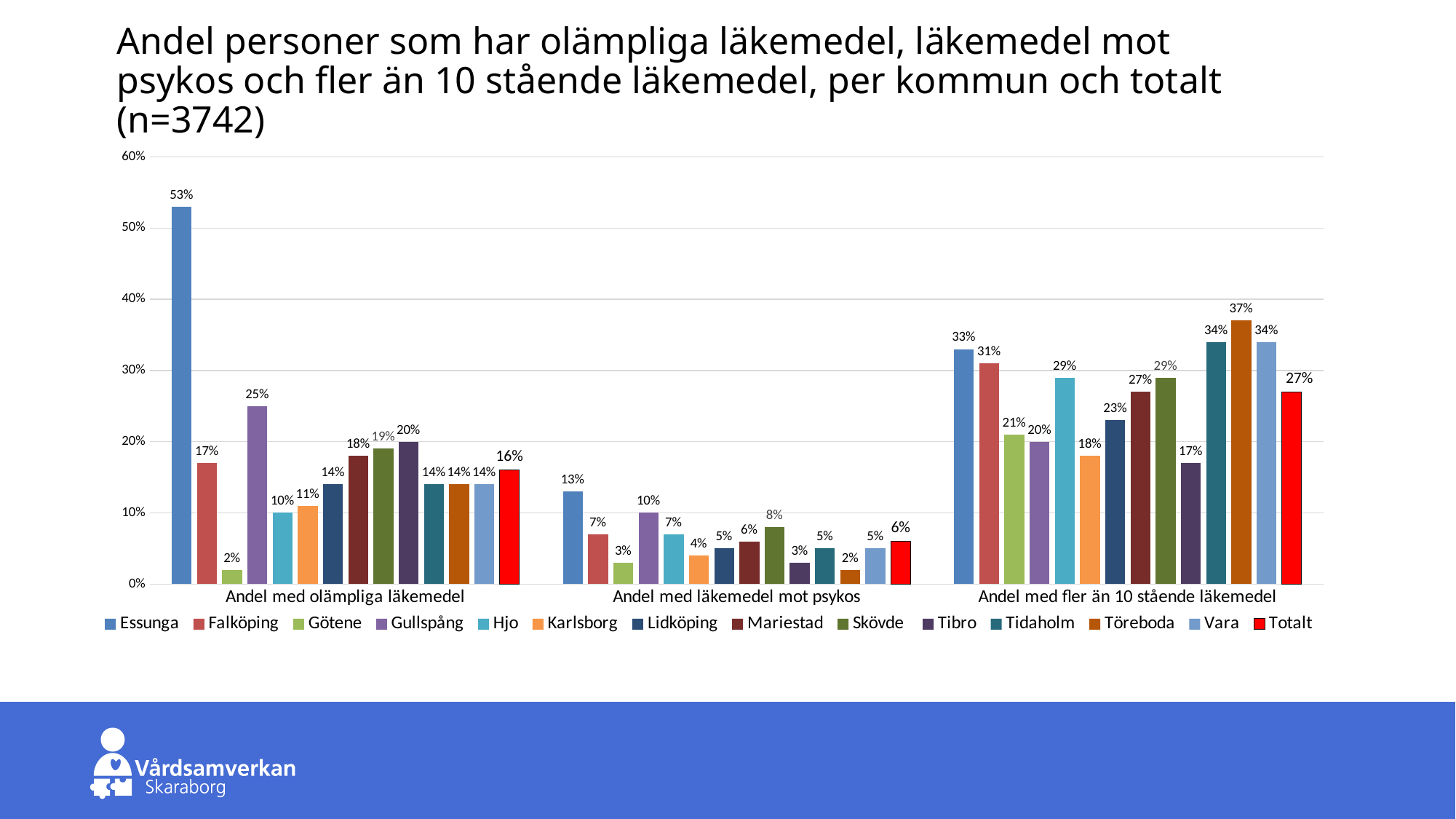
Which municipality has the highest value in the 'Andel med fler än 10 stående läkemedel' category? Töreboda How many series does the legend list? 14 How many categories are shown on the x axis? 3 Which municipality has the lowest value in the 'Andel med olämpliga läkemedel' category? Götene What is the value for Gullspång in the 'Andel med läkemedel mot psykos' category? 10% What is the difference between Essunga and Falköping in the 'Andel med olämpliga läkemedel' category? 36% What is the value for Totalt in the 'Andel med fler än 10 stående läkemedel' category? 27% What kind of chart is shown on the slide? Bar chart Is the value for Töreboda in the 'Andel med fler än 10 stående läkemedel' category greater or less than 30%? greater What colour is the Totalt series in the chart? Red Which is larger in the 'Andel med läkemedel mot psykos' category: Essunga or Skövde? Essunga What is the value for Essunga in the 'Andel med olämpliga läkemedel' category? 53%